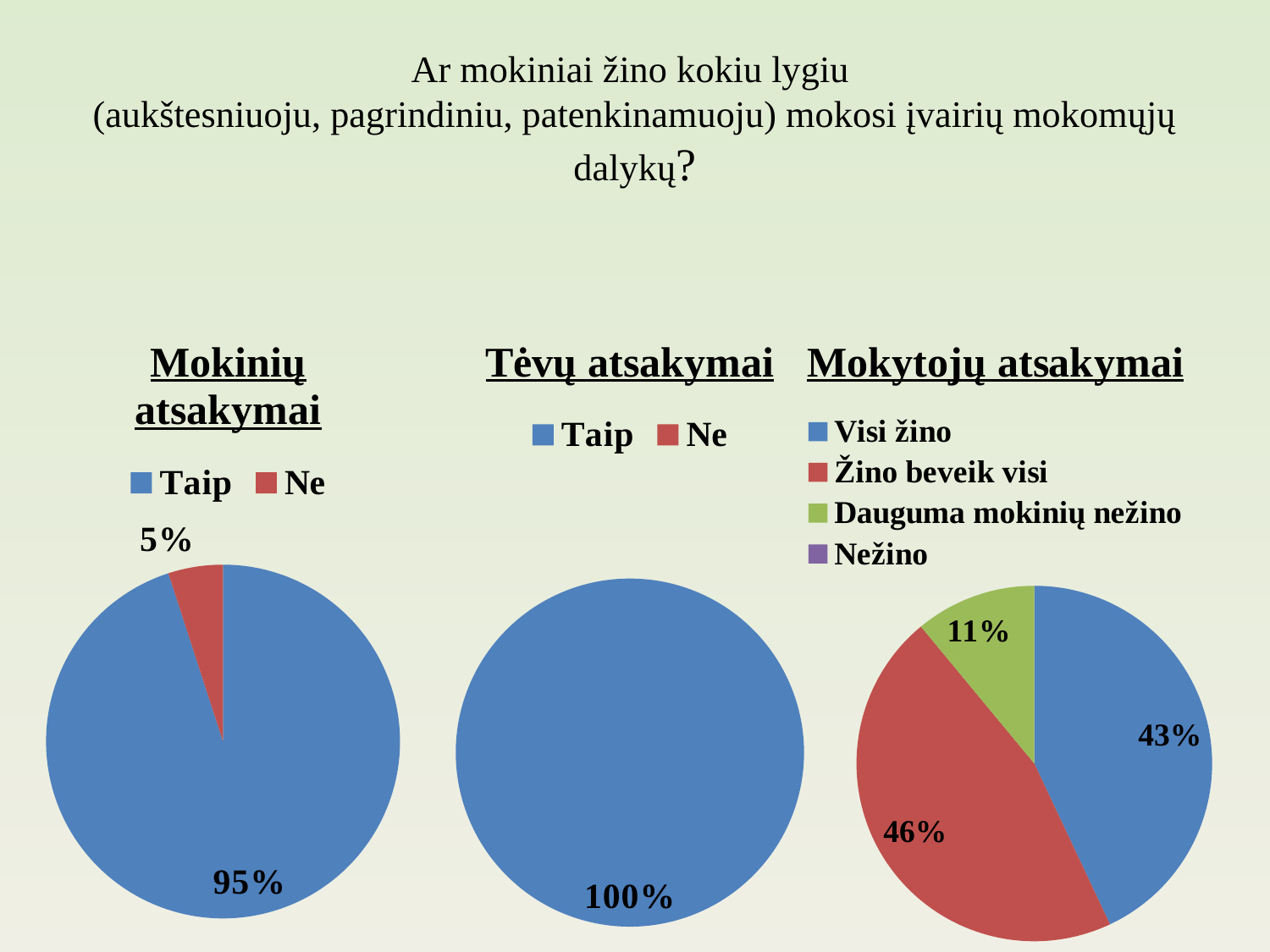
In the 'Mokytojų atsakymai' chart, what is the share for 'Žino beveik visi'? 46% How many entries does the legend of the 'Mokytojų atsakymai' chart list? 4 In the 'Mokytojų atsakymai' chart, which labelled slice is the smallest? Dauguma mokinių nežino In the 'Mokinių atsakymai' chart, what percentage answered 'Ne'? 5% In the 'Mokinių atsakymai' chart, what percentage answered 'Taip'? 95% What type of chart is 'Tėvų atsakymai'? Pie chart In the 'Tėvų atsakymai' chart, what percentage answered 'Taip'? 100% In the 'Mokinių atsakymai' chart, what is the difference between 'Taip' and 'Ne'? 90% In the 'Mokytojų atsakymai' chart, which category has the largest slice? Žino beveik visi In the 'Mokytojų atsakymai' chart, what colour is the 'Visi žino' slice? Blue In the 'Mokytojų atsakymai' chart, what is the share for 'Dauguma mokinių nežino'? 11% In the 'Mokytojų atsakymai' chart, what is the difference between 'Žino beveik visi' and 'Visi žino'? 3%